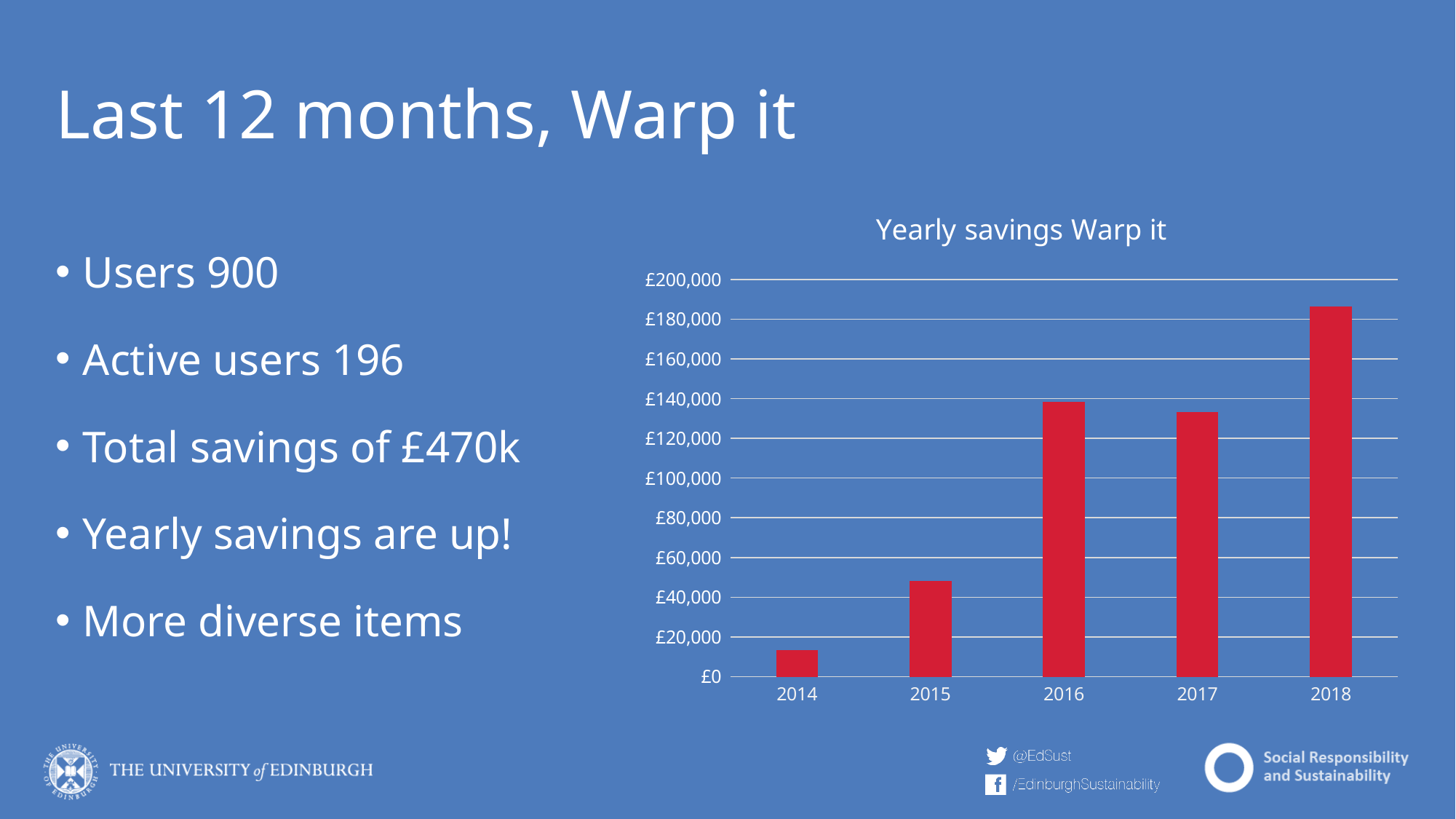
Is the value for 2014 greater or less than £20,000? less Which year has higher yearly savings, 2016 or 2017? 2016 Is the value for 2018 greater or less than £200,000? less What is the title of the chart? Yearly savings Warp it Is the value for 2015 greater or less than £60,000? less Which year has the highest yearly savings? 2018 What colour are the bars in the chart? red Which year has the lowest yearly savings? 2014 What kind of chart is shown on the slide? bar chart How many years are shown on the x axis of the chart? 5